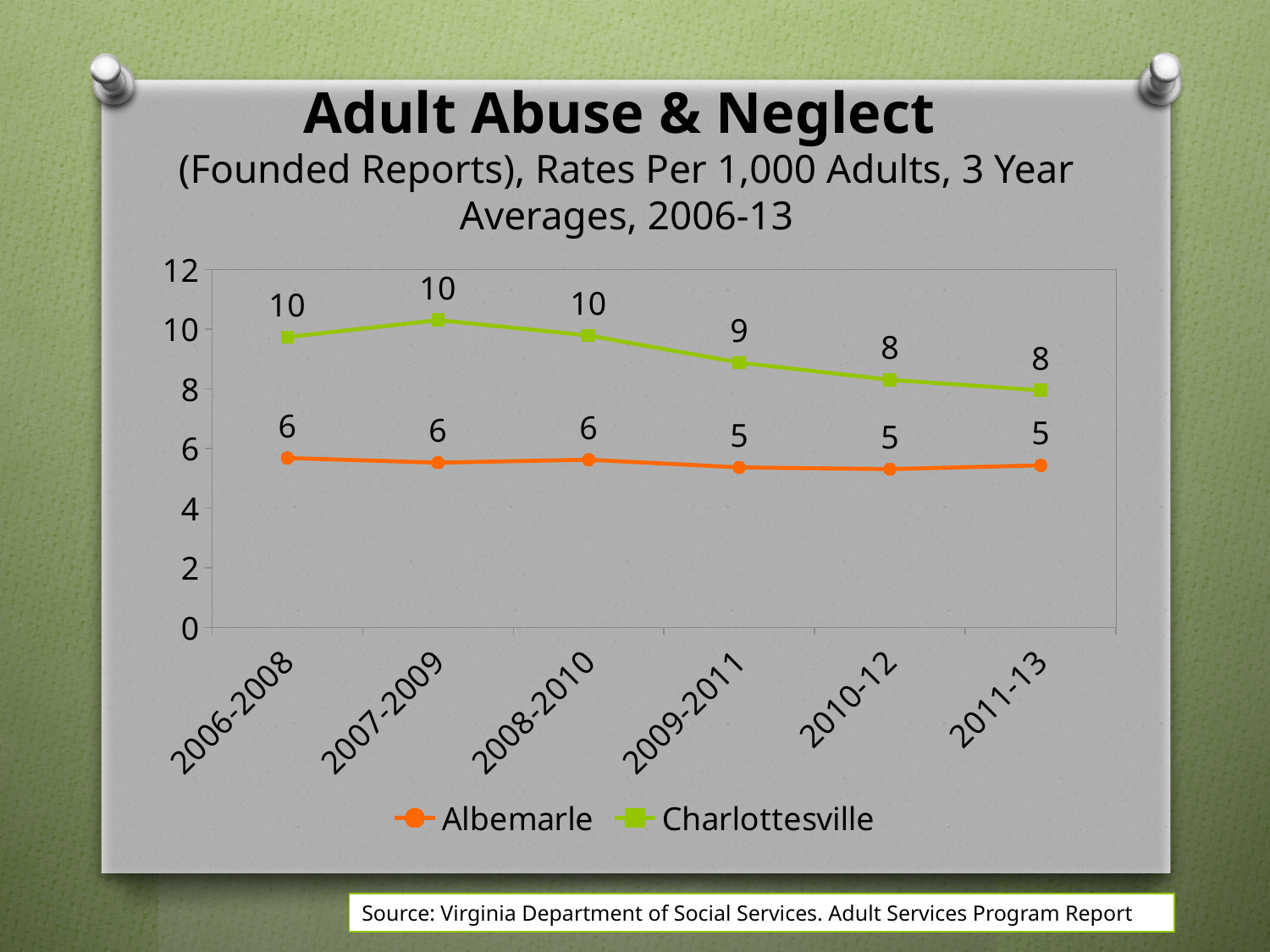
How many time periods are plotted along the x axis? 6 What is the Charlottesville value for 2011-13? 8 Is the Charlottesville value for 2007-2009 greater or less than 8? greater Which series has the higher value in 2009-2011, Albemarle or Charlottesville? Charlottesville Does the Charlottesville line rise or fall from 2008-2010 to 2011-13? fall What is the difference between the Charlottesville and Albemarle values for 2006-2008? 4 What is the Albemarle value for 2006-2008? 6 Which series is drawn in orange? Albemarle What type of chart is shown on the slide? line chart What is the Albemarle value for 2010-12? 5 What is the Charlottesville value for 2009-2011? 9 How many series does the legend list? 2